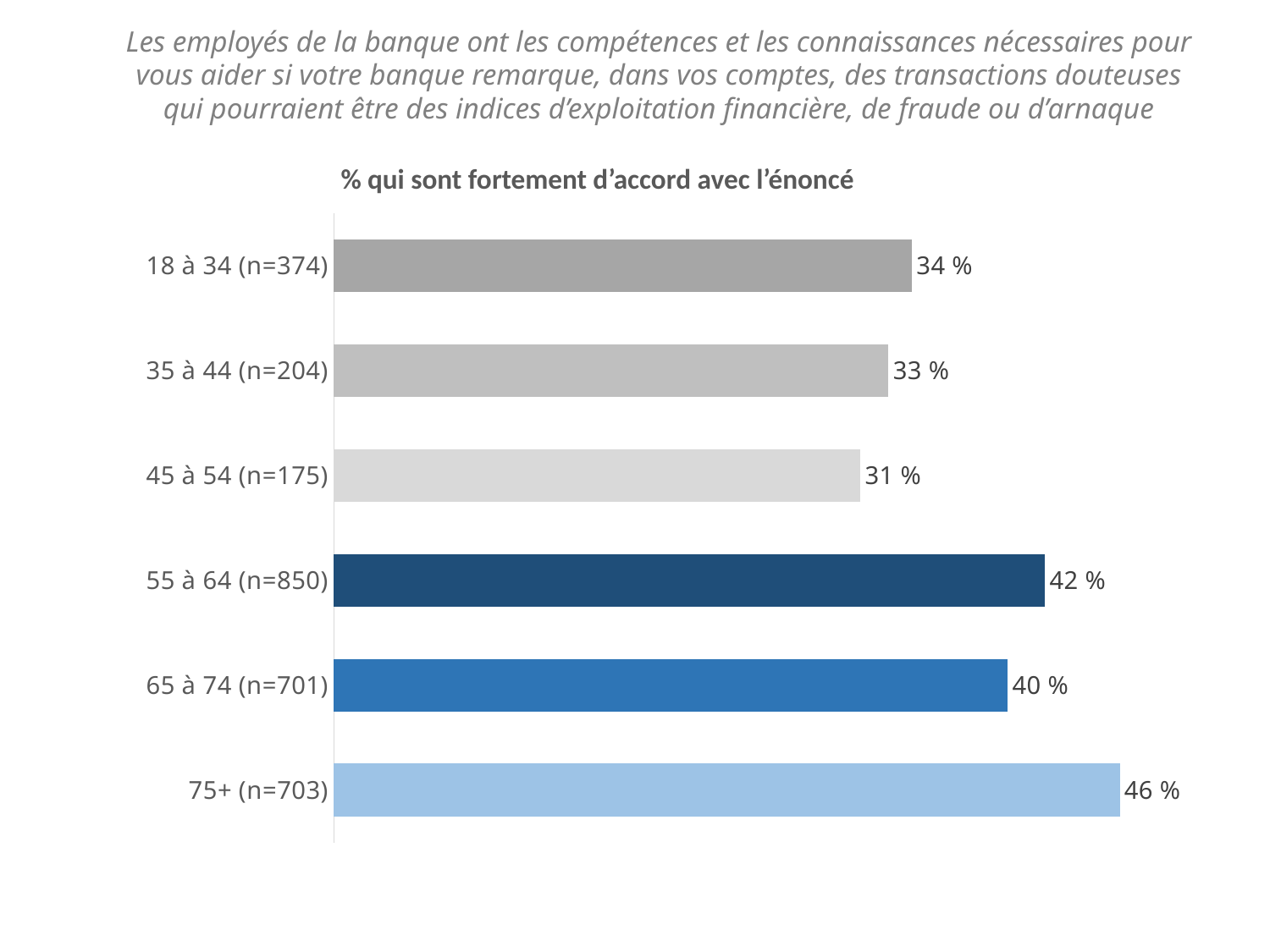
How many age groups are shown in the chart? 6 What kind of chart is shown on the slide? Bar chart What is the value shown for the 65 à 74 (n=701) age group? 40 % What is the difference between the values for the 55 à 64 (n=850) group and the 65 à 74 (n=701) group? 2 % What is the difference between the values for the 75+ (n=703) group and the 45 à 54 (n=175) group? 15 % What colour is the bar for the 55 à 64 (n=850) group? Dark blue Which age group has the highest percentage strongly agreeing with the statement? 75+ (n=703) What is the subtitle printed directly above the chart? % qui sont fortement d'accord avec l'énoncé What is the value shown for the 55 à 64 (n=850) age group? 42 % Which age group has the lowest percentage strongly agreeing with the statement? 45 à 54 (n=175) Which has a higher value: the 35 à 44 (n=204) group or the 65 à 74 (n=701) group? 65 à 74 (n=701) What percentage of the 18 à 34 (n=374) group strongly agrees with the statement? 34 %